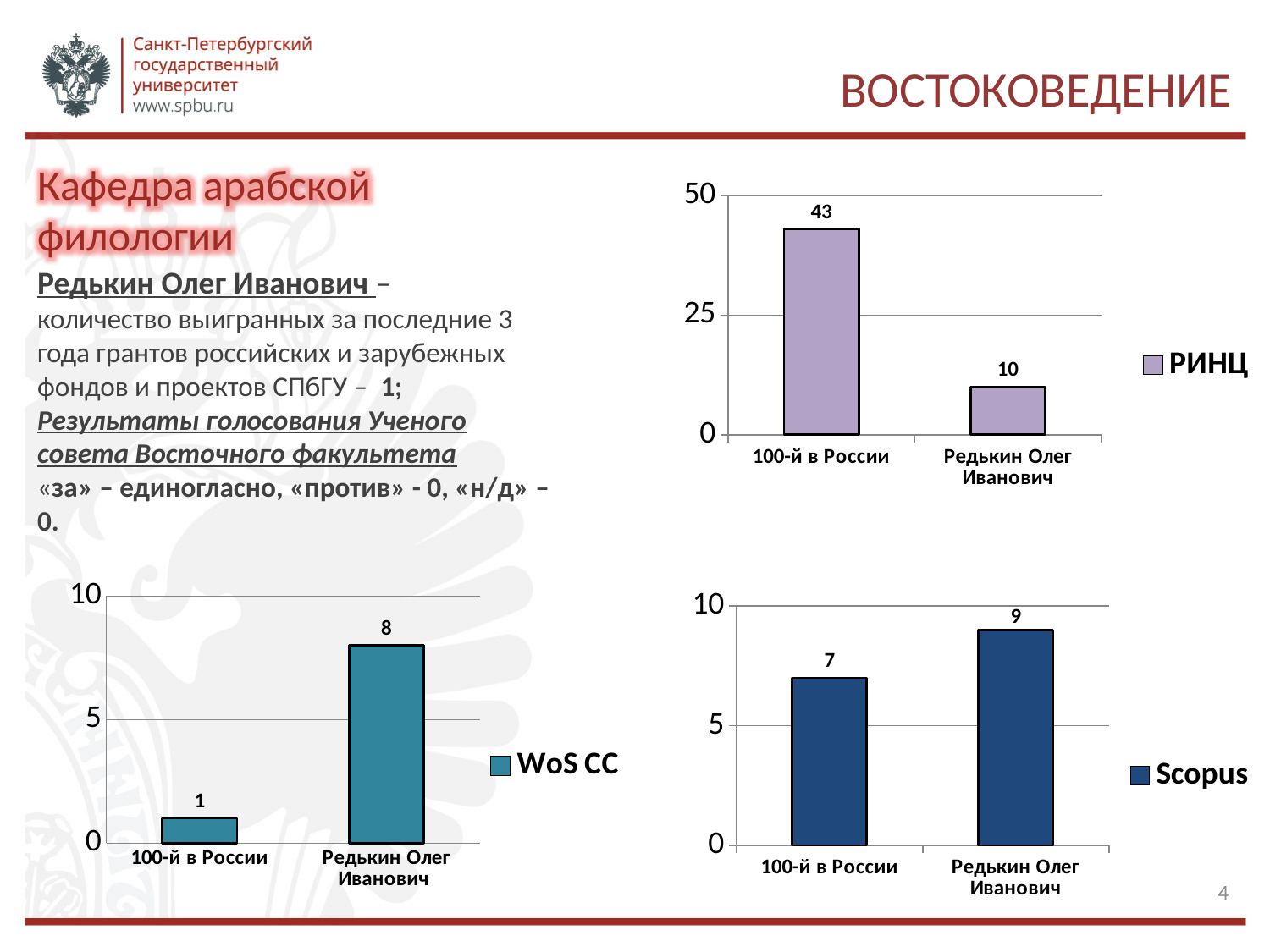
In the WoS CC chart (bottom left), what is the value for 100-й в России? 1 In the WoS CC chart (bottom left), which category has the higher value? Редькин Олег Иванович In the РИНЦ chart (top right), what is the value for 100-й в России? 43 In the Scopus chart (bottom right), what is the value for 100-й в России? 7 In the РИНЦ chart (top right), what is the difference between the values for 100-й в России and Редькин Олег Иванович? 33 In the РИНЦ chart (top right), what is the value for Редькин Олег Иванович? 10 How many categories are shown in the WoS CC chart (bottom left)? 2 In the Scopus chart (bottom right), what is the value for Редькин Олег Иванович? 9 What kind of chart is the Scopus chart (bottom right)? bar chart In the РИНЦ chart (top right), is the value for 100-й в России greater or less than 25? greater In the WoS CC chart (bottom left), what is the value for Редькин Олег Иванович? 8 In the Scopus chart (bottom right), what is the difference between the values for Редькин Олег Иванович and 100-й в России? 2